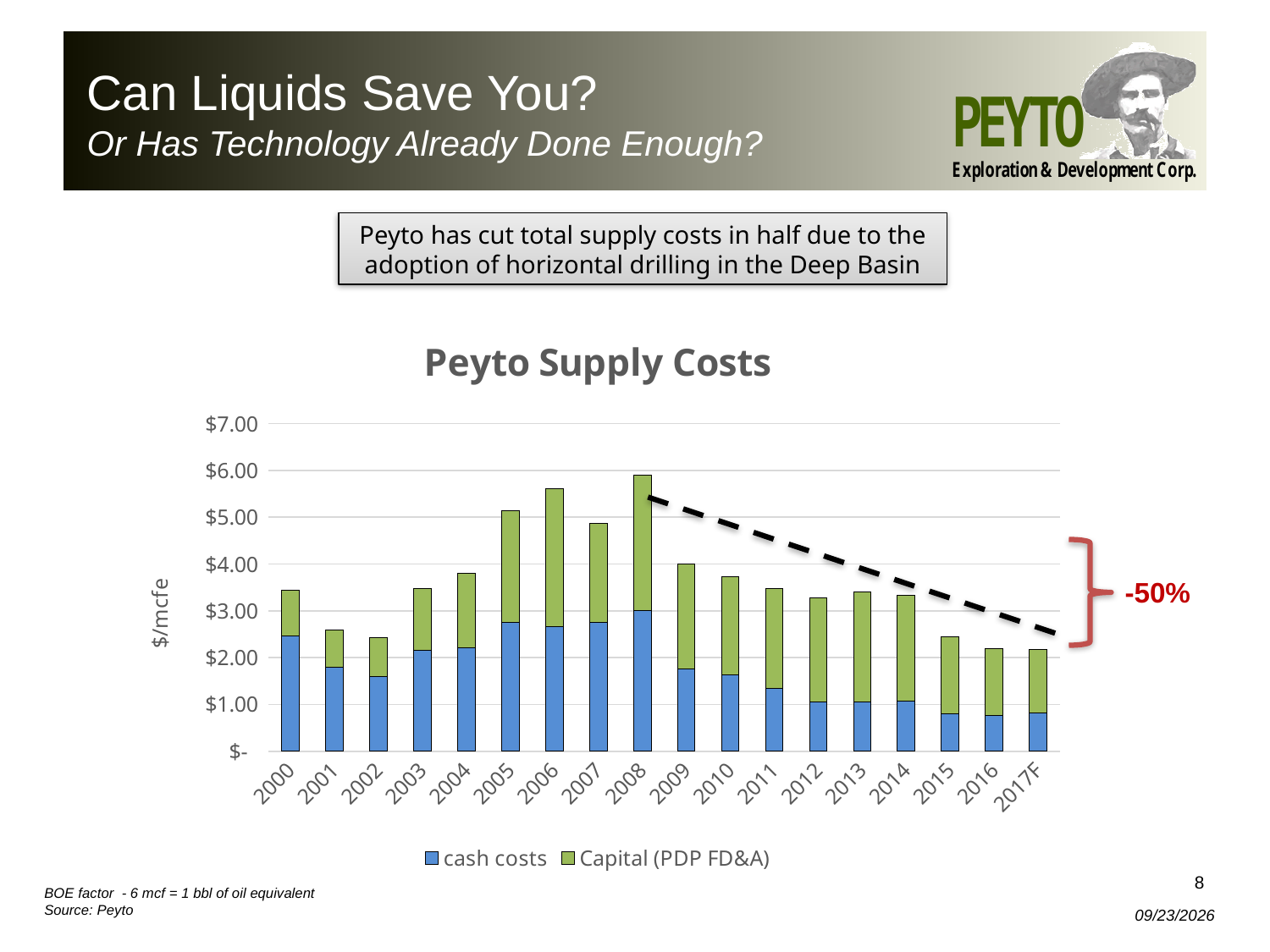
Do total supply costs rise or fall from 2008 to 2017F? fall How many years (categories) are shown on the x axis? 18 What is the title of the chart? Peyto Supply Costs Is the cash costs value for 2005 greater or less than $2.00? greater Is the total supply cost for 2002 greater or less than $3.00? less What type of chart is shown on the slide? stacked bar chart Which year has the highest total supply cost? 2008 What are the two series named in the legend? cash costs and Capital (PDP FD&A) Is the cash costs value for 2016 greater or less than $1.00? less How many series does the legend list? 2 Which year has the larger total supply cost, 2005 or 2009? 2005